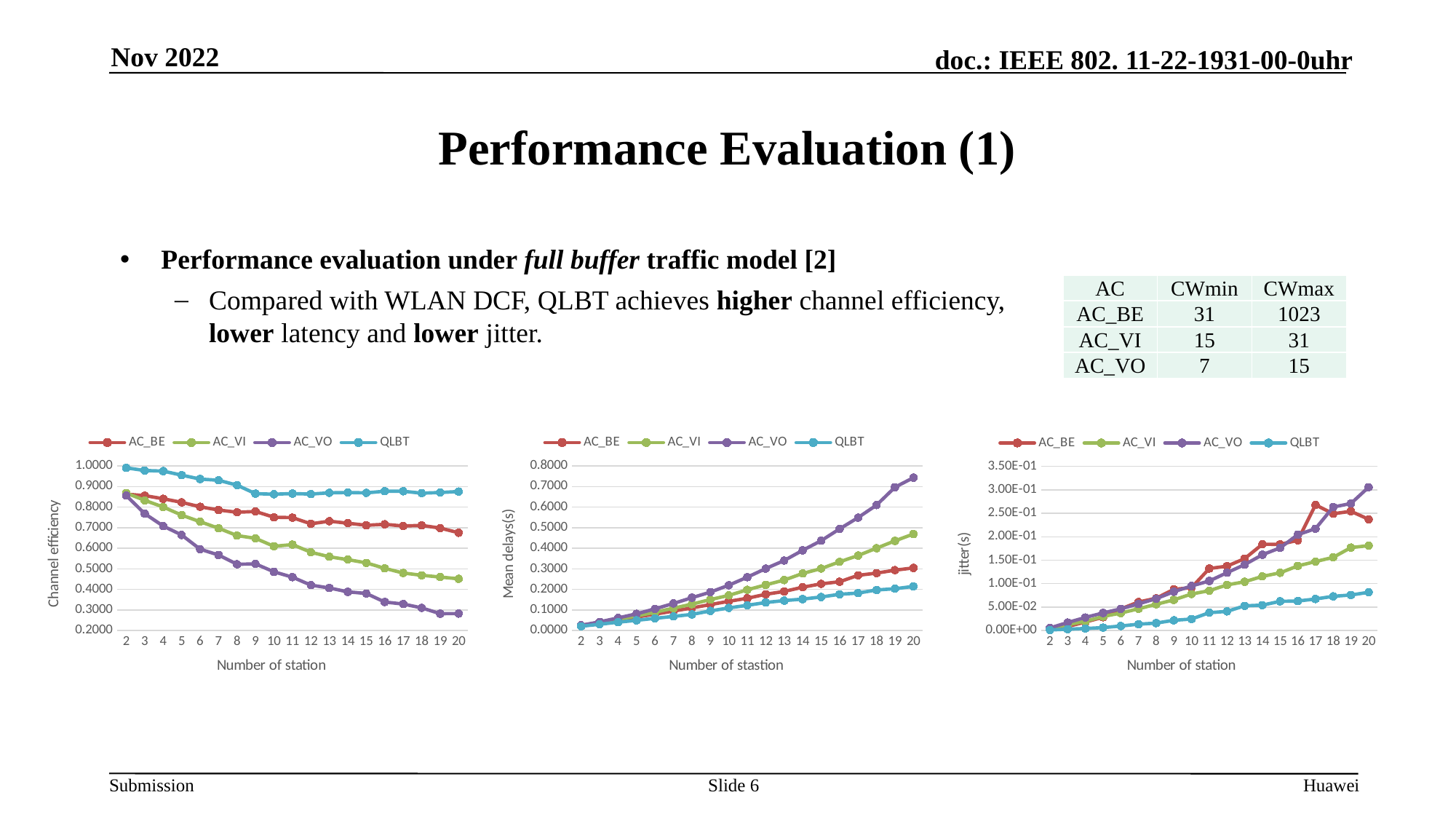
In the middle chart (Mean delays), do the values rise or fall as the number of stations increases? rise In the left chart (Channel efficiency), is the AC_VI value at 20 stations greater or less than 0.5000? less What kind of chart is the left chart (Channel efficiency)? line chart In the right chart (jitter), which series has the lowest value at 20 stations? QLBT In the right chart (jitter), is the QLBT value at 20 stations greater or less than 1.00E-01? less In the middle chart (Mean delays), is the AC_VO value at 20 stations greater or less than 0.7000? greater In the right chart (jitter), which is larger at 20 stations, AC_VO or AC_VI? AC_VO In the left chart (Channel efficiency), which series has the highest value at 20 stations? QLBT In the middle chart (Mean delays), which series has the highest value at 20 stations? AC_VO How many series does the legend of the middle chart (Mean delays) list? 4 In the left chart (Channel efficiency), which series has the lowest value at 20 stations? AC_VO